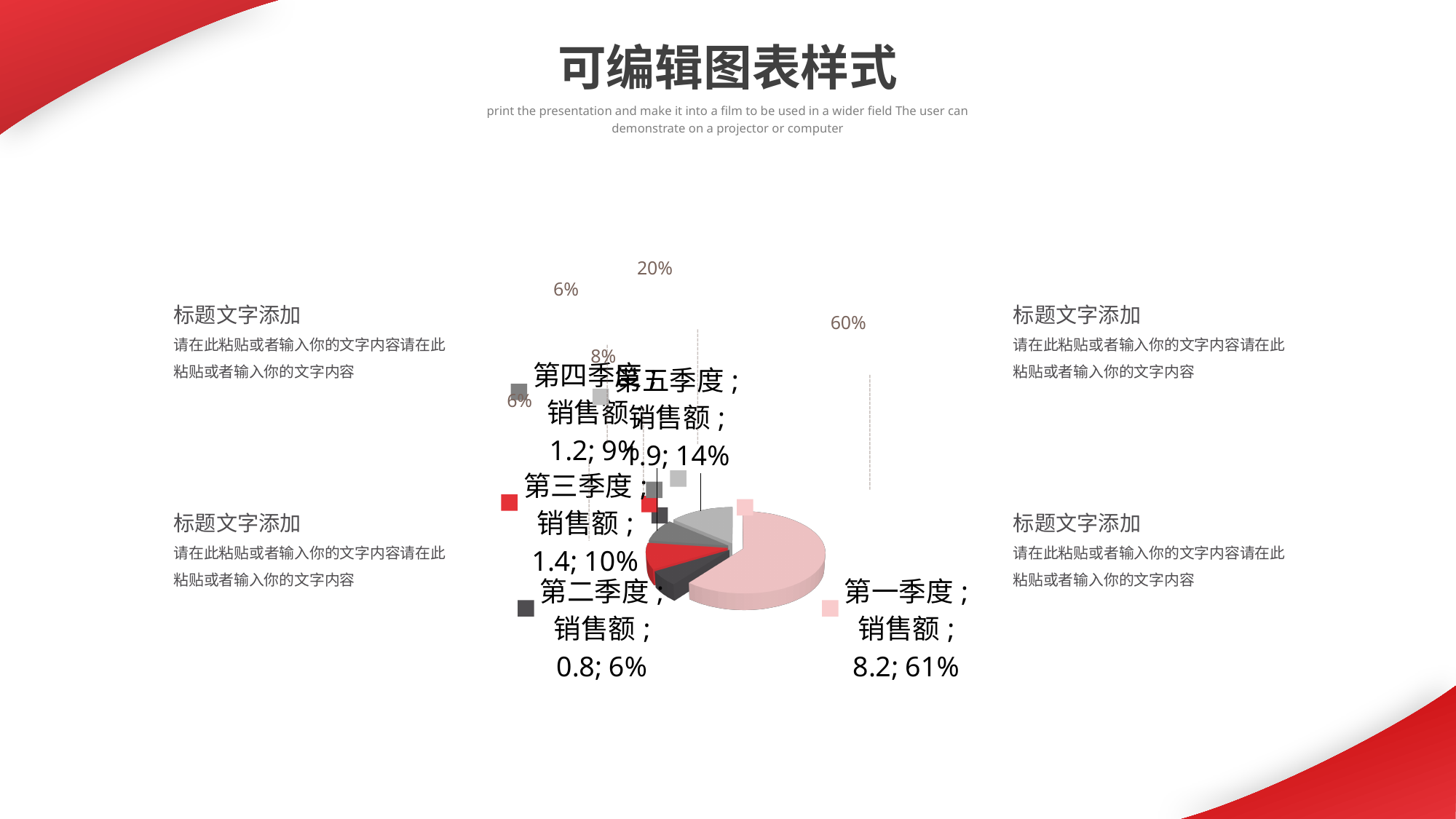
What kind of chart is shown on the slide? pie chart How many slices does the pie chart have? 5 Which quarter has the largest slice in the pie chart? 第一季度 What share of the pie does 第一季度 represent? 61% What is the difference between the sales values of 第一季度 and 第五季度? 6.3 What is the sales value (销售额) for 第三季度 in the pie chart? 1.4 Which quarter has the smallest slice in the pie chart? 第二季度 Which has a larger sales value, 第三季度 or 第四季度? 第三季度 What share of the pie does 第四季度 represent? 9% What is the sales value (销售额) for 第二季度 in the pie chart? 0.8 What is the sales value (销售额) for 第五季度 in the pie chart? 1.9 What is the sales value (销售额) for 第一季度 in the pie chart? 8.2